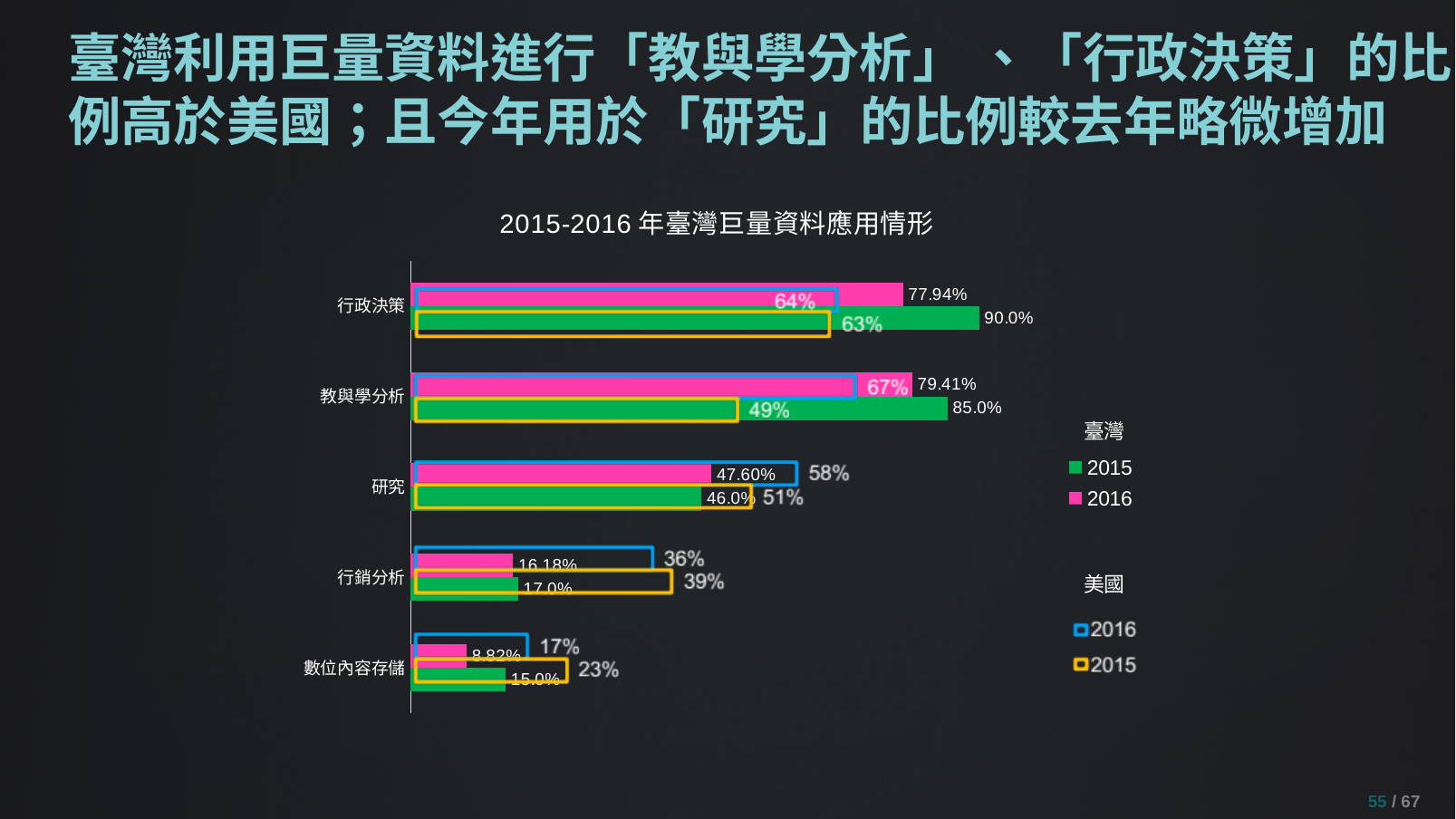
What is the 臺灣 2016 value for 教與學分析? 79.41% What is the difference between the 美國 2016 and 美國 2015 values for 教與學分析? 18% Which category has the lowest 臺灣 2016 value? 數位內容存儲 What is the 美國 2016 value for 研究? 58% For 行銷分析, which is larger: the 美國 2015 value or the 臺灣 2015 value? 美國 2015 What is the 臺灣 2016 value for 數位內容存儲? 8.82% Which category has the highest 臺灣 2015 value? 行政決策 What is the 臺灣 2015 value for 行政決策? 90.0% How many series does the legend list in total? 4 What is the title of the chart? 2015-2016 年臺灣巨量資料應用情形 How many categories are shown on the chart? 5 What type of chart is shown on the slide? bar chart